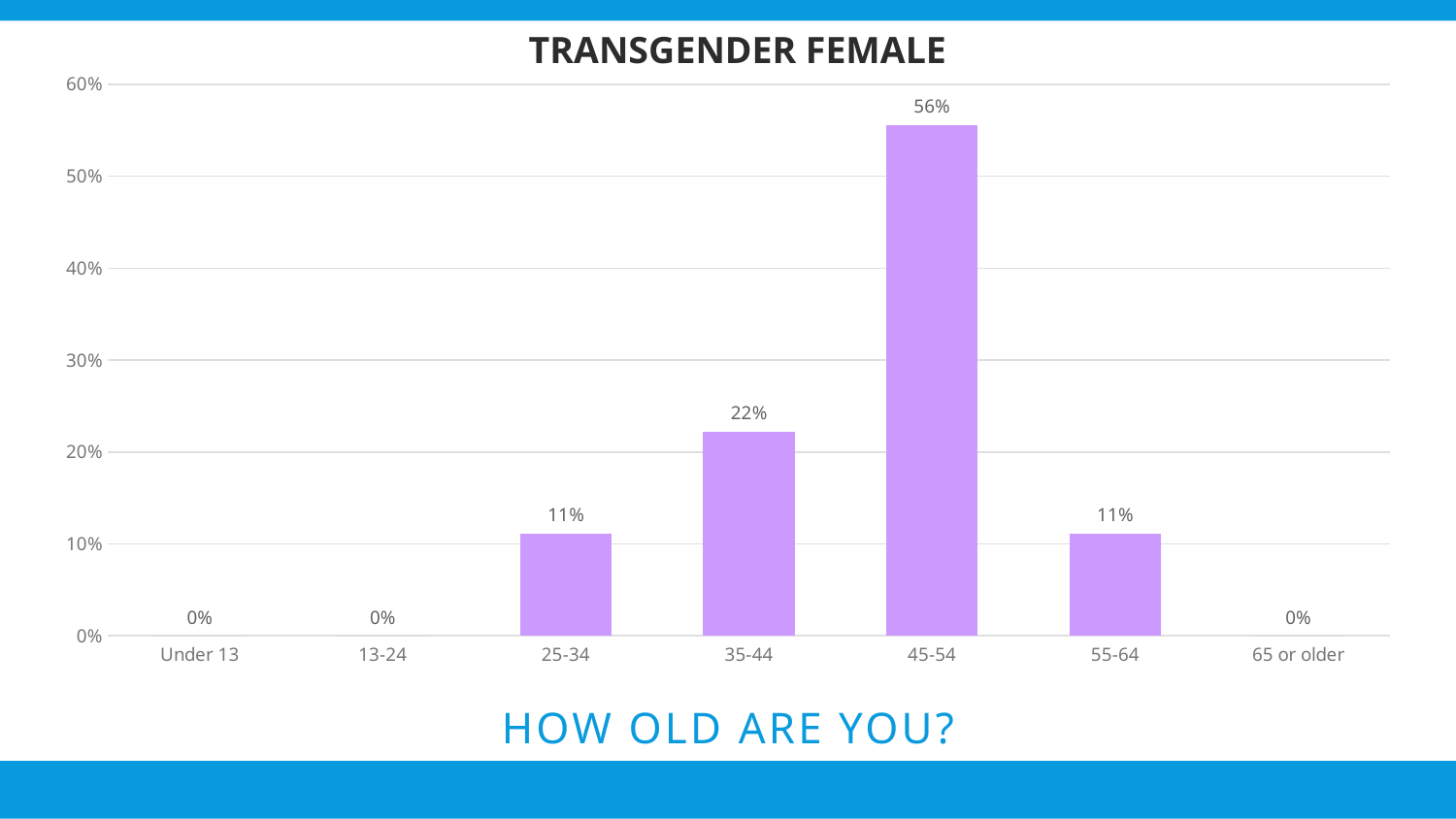
Which age group has the highest value? 45-54 What is the value for the 45-54 age group? 56% What is the difference between the values for 45-54 and 35-44? 34% What is the difference between the values for 35-44 and 55-64? 11% What kind of chart is shown on the slide? Bar chart How many age categories are shown on the x axis? 7 Is the value for 45-54 greater or less than 50%? greater What is the value for the 35-44 age group? 22% What is the value for the 65 or older age group? 0% Which is larger, the value for 35-44 or the value for 55-64? 35-44 What is the title of the chart? TRANSGENDER FEMALE What is the value for the 25-34 age group? 11%